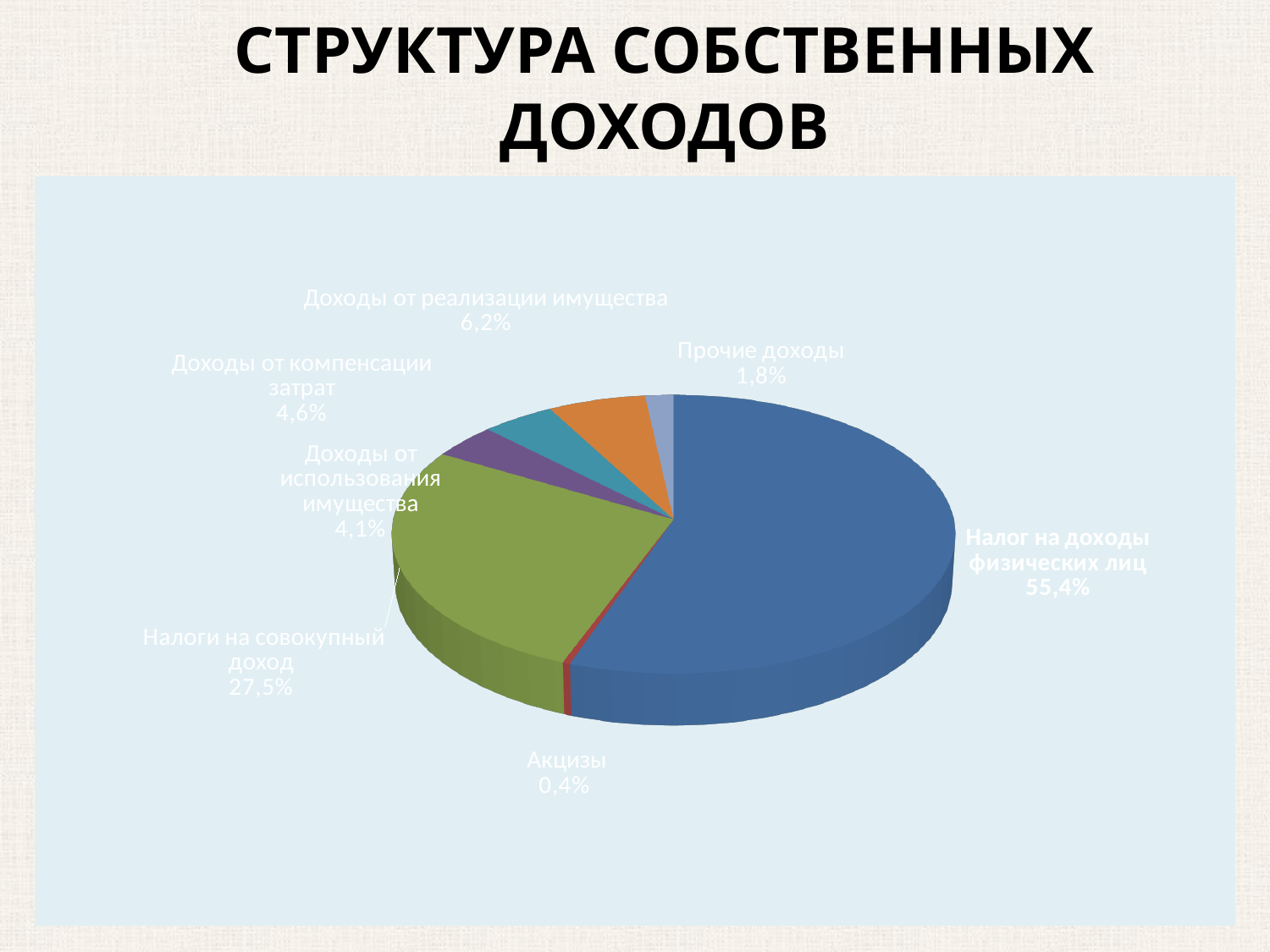
Which category has the smallest slice of the pie? Акцизы What is the value shown for Доходы от реализации имущества? 6,2% What is the difference between Налог на доходы физических лиц and Налоги на совокупный доход? 27,9% What is the title of the slide? СТРУКТУРА СОБСТВЕННЫХ ДОХОДОВ What is the value shown for Акцизы? 0,4% How many categories are shown in the pie chart? 7 Which category has the largest slice of the pie? Налог на доходы физических лиц What is the value shown for Налоги на совокупный доход? 27,5% What is the value shown for Прочие доходы? 1,8% What share of the pie does Налог на доходы физических лиц have? 55,4% Which is larger, Доходы от компенсации затрат or Доходы от использования имущества? Доходы от компенсации затрат What kind of chart is shown on the slide? Pie chart